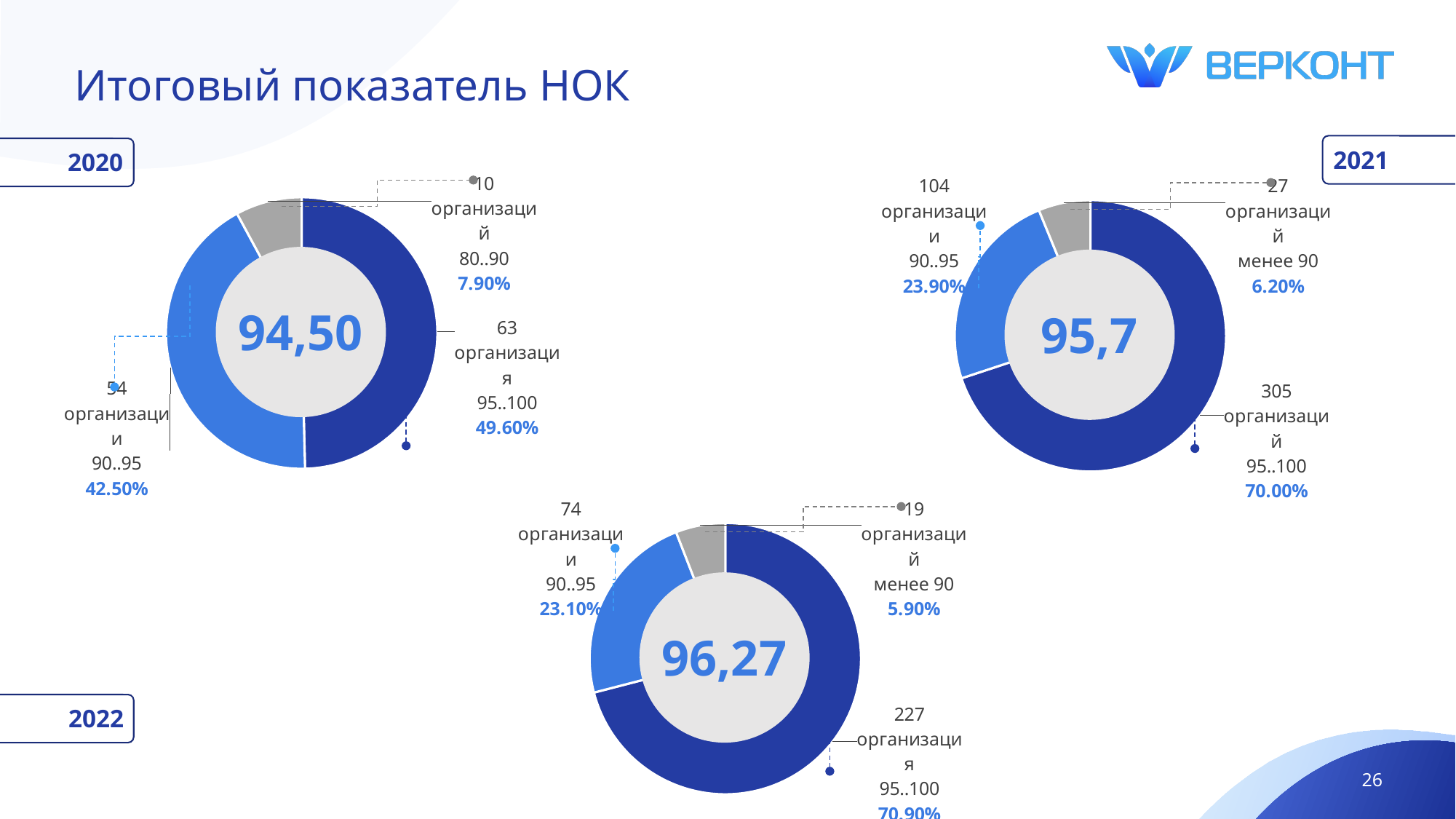
In the 2021 chart, how many organisations are in the 'менее 90' range? 27 In the 2022 chart, what is the difference in percentage points between the 95..100 share and the 90..95 share? 47.80% What kind of charts are shown on the slide? Donut (pie) charts In the 2020 chart, what is the value shown in the centre of the donut? 94,50 In the 2021 chart, which range has the largest share? 95..100 How many donut charts are on the slide? 3 In the 2021 chart, what is the value shown in the centre of the donut? 95,7 Which is larger: the 90..95 share in the 2020 chart or the 90..95 share in the 2022 chart? 2020 (42.50%) In the 2022 chart, what is the value shown in the centre of the donut? 96,27 In the 2020 chart, what share of organisations fall in the 95..100 range? 49.60% In the 2020 chart, how many organisations are in the 90..95 range? 54 In the 2022 chart, which range has the smallest share? менее 90